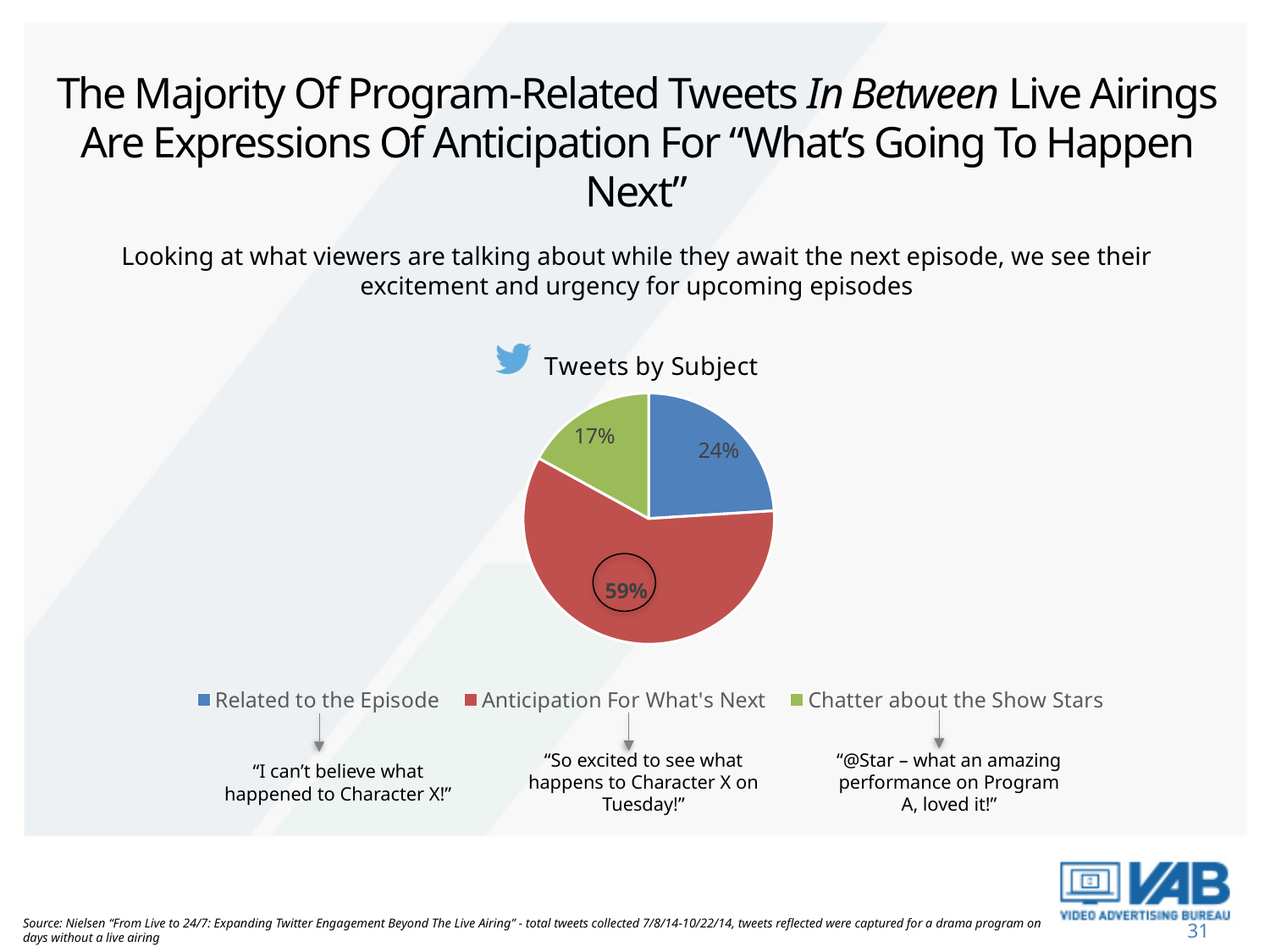
Which subject has the largest share of tweets? Anticipation For What's Next What is the difference in percentage points between Anticipation For What's Next and Related to the Episode? 35 How many slices does the pie chart have? 3 Which is larger: the share for Related to the Episode or the share for Chatter about the Show Stars? Related to the Episode What colour is the slice for Anticipation For What's Next? red What is the title of the chart? Tweets by Subject How many entries does the legend list? 3 Which subject has the smallest share of tweets? Chatter about the Show Stars What percentage of tweets are Anticipation For What's Next? 59% What percentage of tweets are Chatter about the Show Stars? 17% What percentage of tweets are Related to the Episode? 24% What type of chart is shown on the slide? pie chart